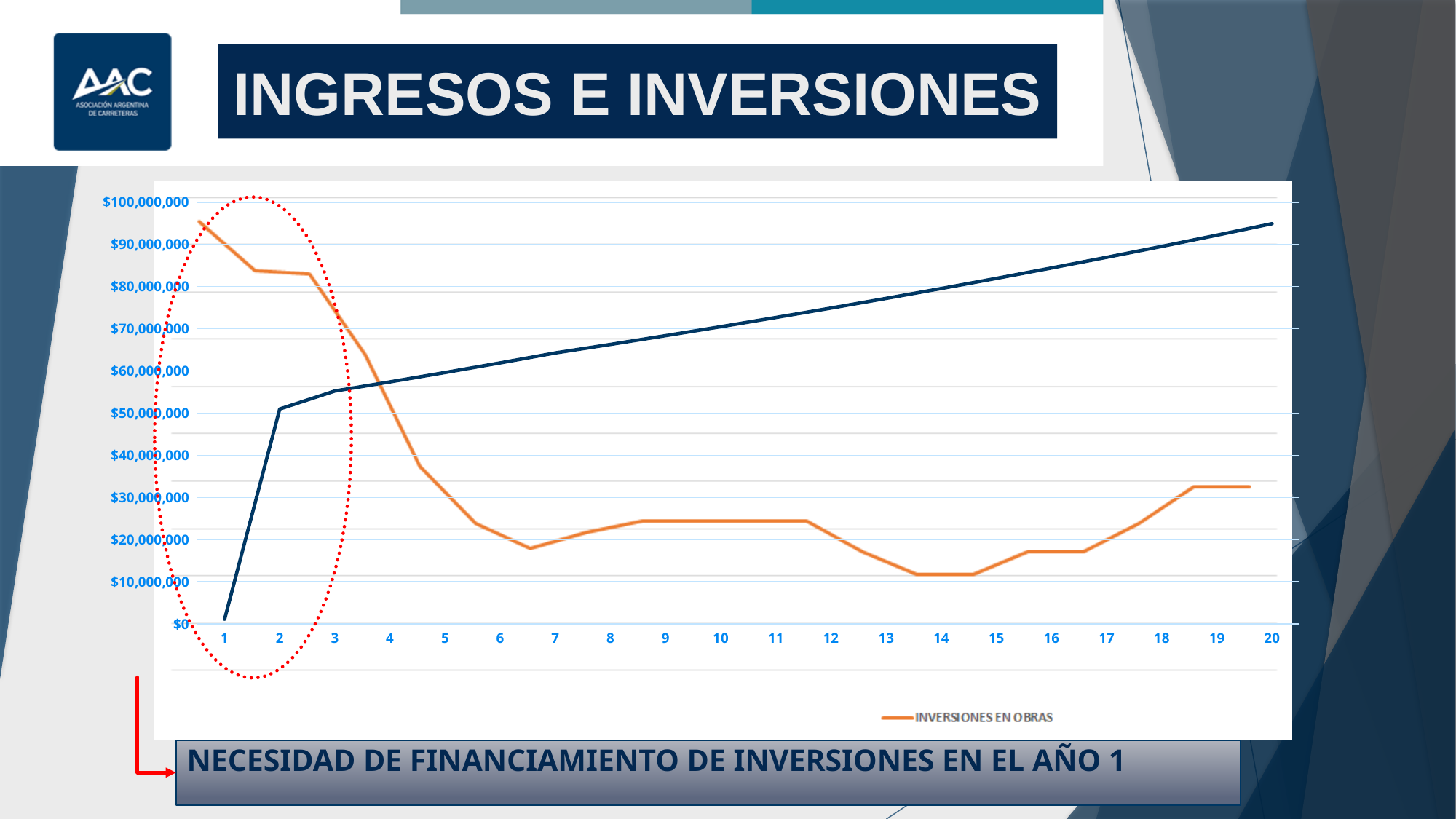
Is the value of INVERSIONES EN OBRAS at year 1 greater or less than $90,000,000? greater What colour is the INVERSIONES EN OBRAS line? Orange In which year does INVERSIONES EN OBRAS reach its highest value? 1 How many points (years) are plotted along the x axis? 20 How many series does the legend list? 1 What kind of chart is shown on the slide? Line chart At year 1, which line is higher: the orange INVERSIONES EN OBRAS line or the dark blue line? INVERSIONES EN OBRAS (orange) Is the value of INVERSIONES EN OBRAS at year 14 greater or less than $20,000,000? less Is the value of the dark blue line at year 1 greater or less than $10,000,000? less What is the name of the series listed in the legend? INVERSIONES EN OBRAS At year 20, which line is higher: the orange INVERSIONES EN OBRAS line or the dark blue line? The dark blue line